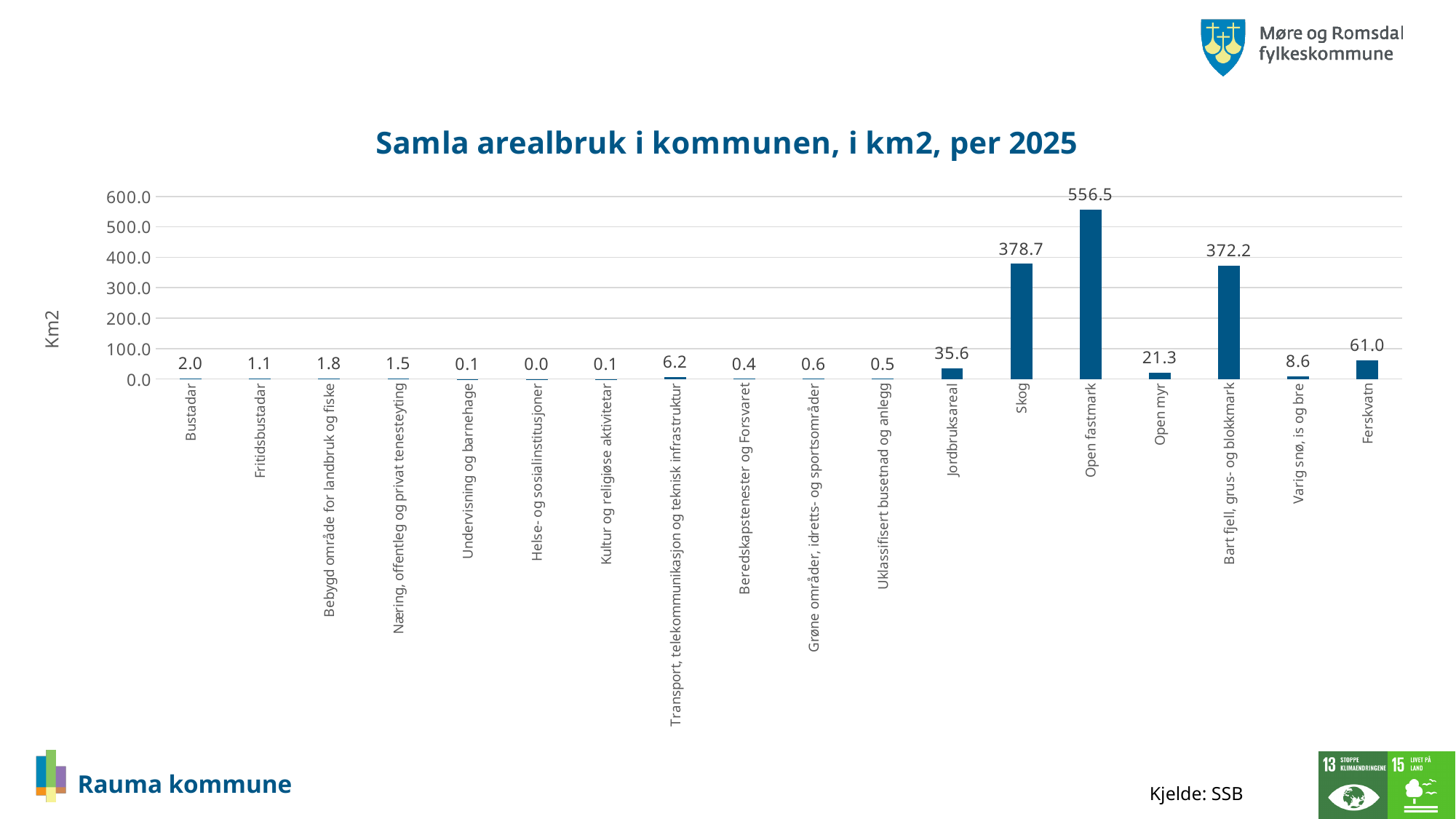
What is the value for Skog? 378.7 Which category has the highest value? Open fastmark Is the value for Open fastmark greater or less than 500.0? greater What is the value for Ferskvatn? 61.0 What is the difference between the values for Open fastmark and Skog? 177.8 Which category has the lowest value? Helse- og sosialinstitusjoner What is the value for Open fastmark? 556.5 How many categories are shown on the x axis? 18 Which is larger, the value for Skog or the value for Bart fjell, grus- og blokkmark? Skog What is the value for Transport, telekommunikasjon og teknisk infrastruktur? 6.2 What is the difference between the values for Ferskvatn and Jordbruksareal? 25.4 What is the title of the chart? Samla arealbruk i kommunen, i km2, per 2025